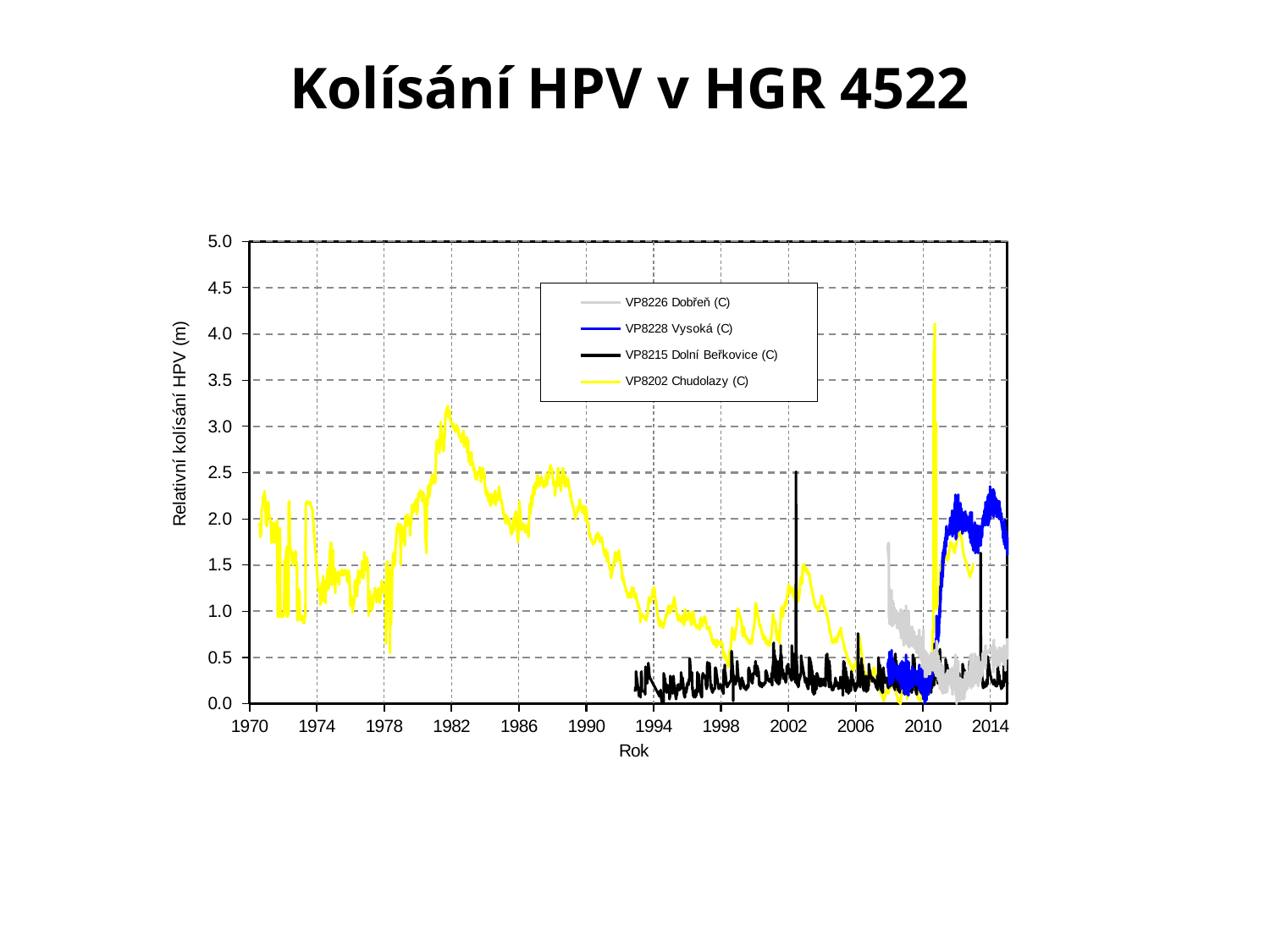
Does the VP8202 Chudolazy (C) series generally rise or fall between 1982 and 1998? fall Which series is drawn in yellow? VP8202 Chudolazy (C) What is the title of the chart? Kolísání HPV v HGR 4522 Which series reaches the highest value anywhere on the chart? VP8202 Chudolazy (C) Is the value for VP8228 Vysoká (C) around 2012 greater or less than 1.5? greater Is the value for VP8215 Dolní Beřkovice (C) around 1996 greater or less than 1.0? less Around 2012, which series has the larger value: VP8228 Vysoká (C) or VP8226 Dobřeň (C)? VP8228 Vysoká (C) Is the value for VP8226 Dobřeň (C) around 2013 greater or less than 1.0? less How many series does the legend list? 4 What kind of chart is shown on the slide? line chart